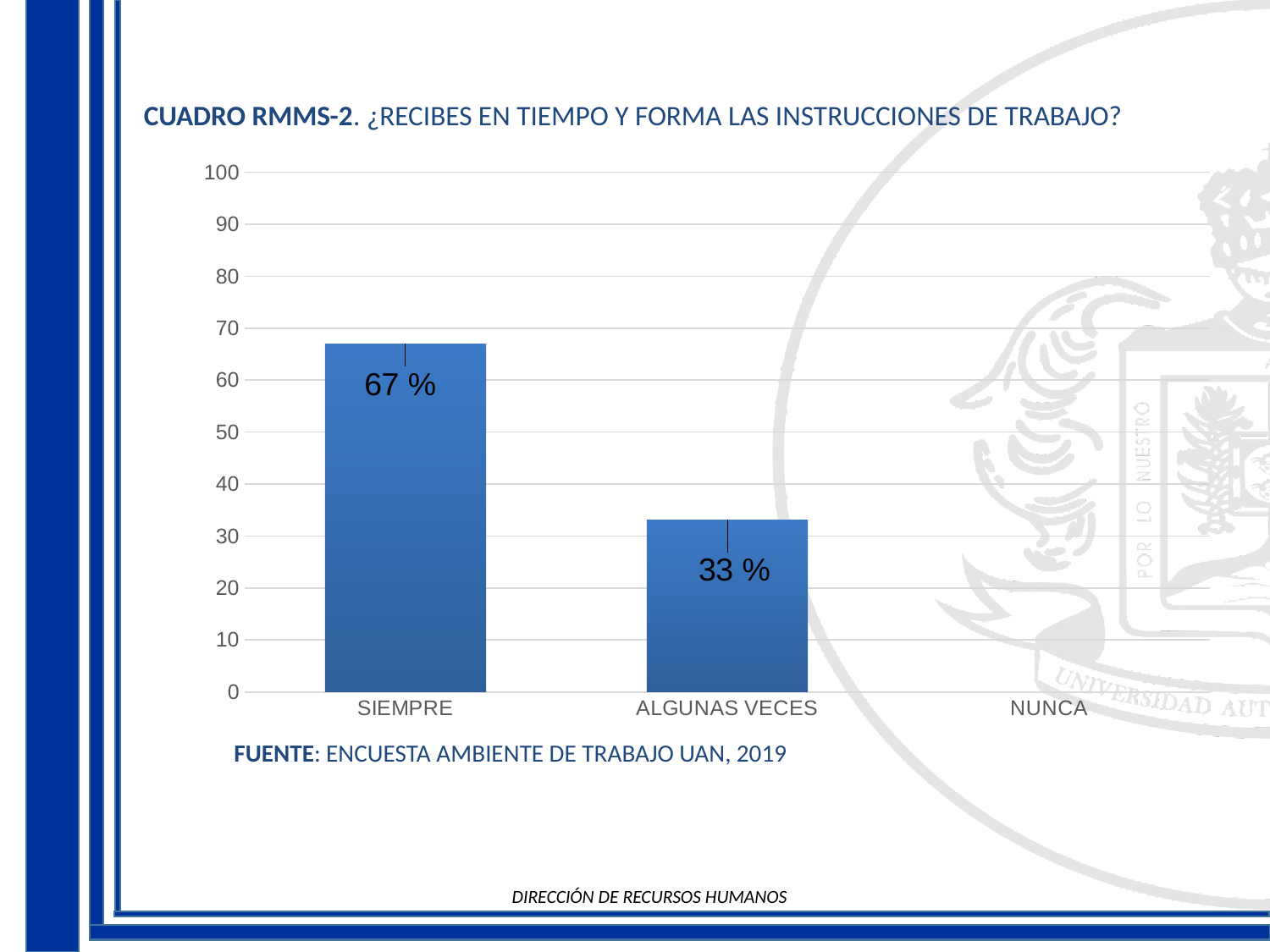
What kind of chart is shown on the slide? Bar chart What is the value for ALGUNAS VECES? 33 % What is the difference between the values for SIEMPRE and ALGUNAS VECES? 34 % Which is larger, the value for SIEMPRE or the value for ALGUNAS VECES? SIEMPRE What is the value for SIEMPRE? 67 % Which category has the highest value? SIEMPRE Is the value for SIEMPRE greater or less than 60? greater Do the values rise or fall from SIEMPRE to ALGUNAS VECES? Fall Is the value for ALGUNAS VECES greater or less than 40? less How many categories are shown on the x axis? 3 What source is cited below the chart? ENCUESTA AMBIENTE DE TRABAJO UAN, 2019 What is the highest value shown on the y axis? 100